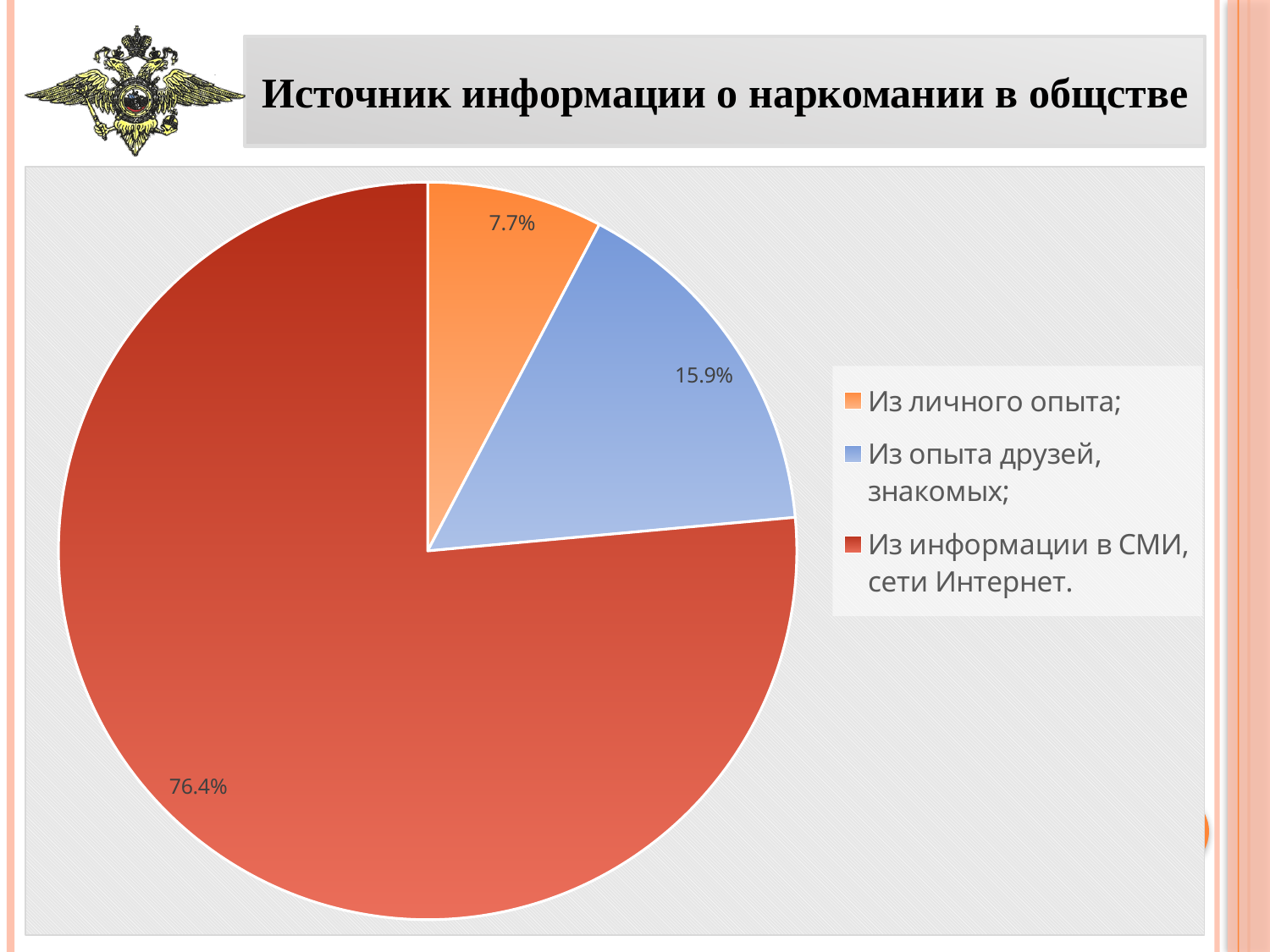
Which category has the largest slice of the pie? Из информации в СМИ, сети Интернет. Which is larger: the share for 'Из опыта друзей, знакомых;' or the share for 'Из личного опыта;'? Из опыта друзей, знакомых; How many categories does the pie chart have? 3 What share of the pie is labelled 'Из опыта друзей, знакомых;'? 15.9% Which category has the smallest slice of the pie? Из личного опыта; What is the title of the slide containing the chart? Источник информации о наркомании в общстве What share of the pie is labelled 'Из информации в СМИ, сети Интернет.'? 76.4% What colour is the slice for 'Из опыта друзей, знакомых;'? blue What type of chart is shown on the slide? pie chart What is the difference between the shares for 'Из опыта друзей, знакомых;' and 'Из личного опыта;'? 8.2% What share of the pie is labelled 'Из личного опыта;'? 7.7% What is the difference between the shares for 'Из информации в СМИ, сети Интернет.' and 'Из опыта друзей, знакомых;'? 60.5%